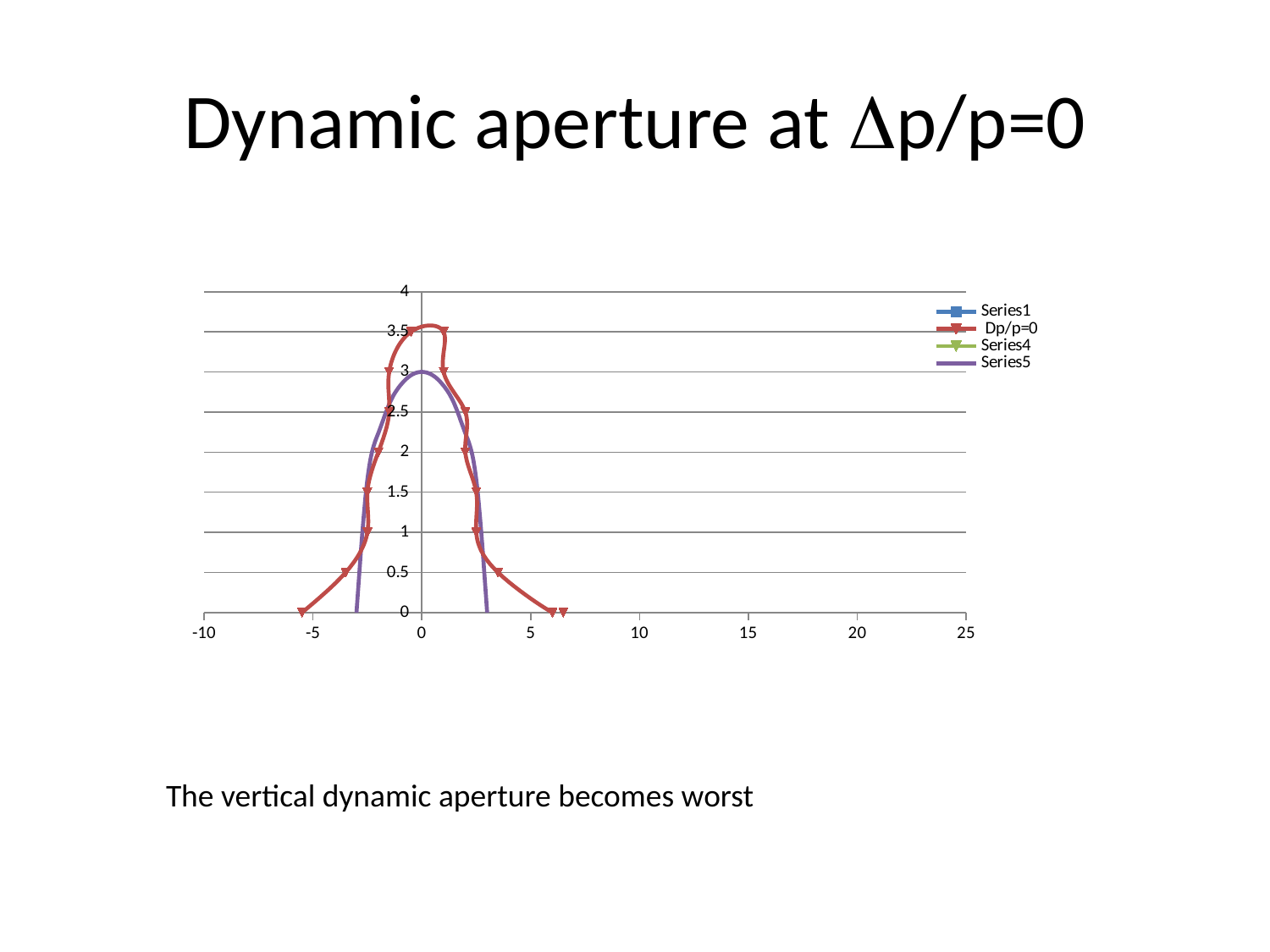
Which legend entry corresponds to the red line with triangle markers? Dp/p=0 Is the peak value of the Dp/p=0 series greater or less than 3? greater Is the rightmost x position reached by the purple Series5 curve greater or less than 5? less Is the peak value of the purple Series5 curve greater or less than 3.5? less How many series does the legend list? 4 What kind of chart is shown on the slide? line chart What is the title of the slide containing the chart? Dynamic aperture at Δp/p=0 Does the Dp/p=0 series rise or fall as x increases from 0 to 5? fall Which series reaches a higher peak value, Dp/p=0 or Series5? Dp/p=0 Does the Dp/p=0 series rise or fall as x increases from -5 to 0? rise